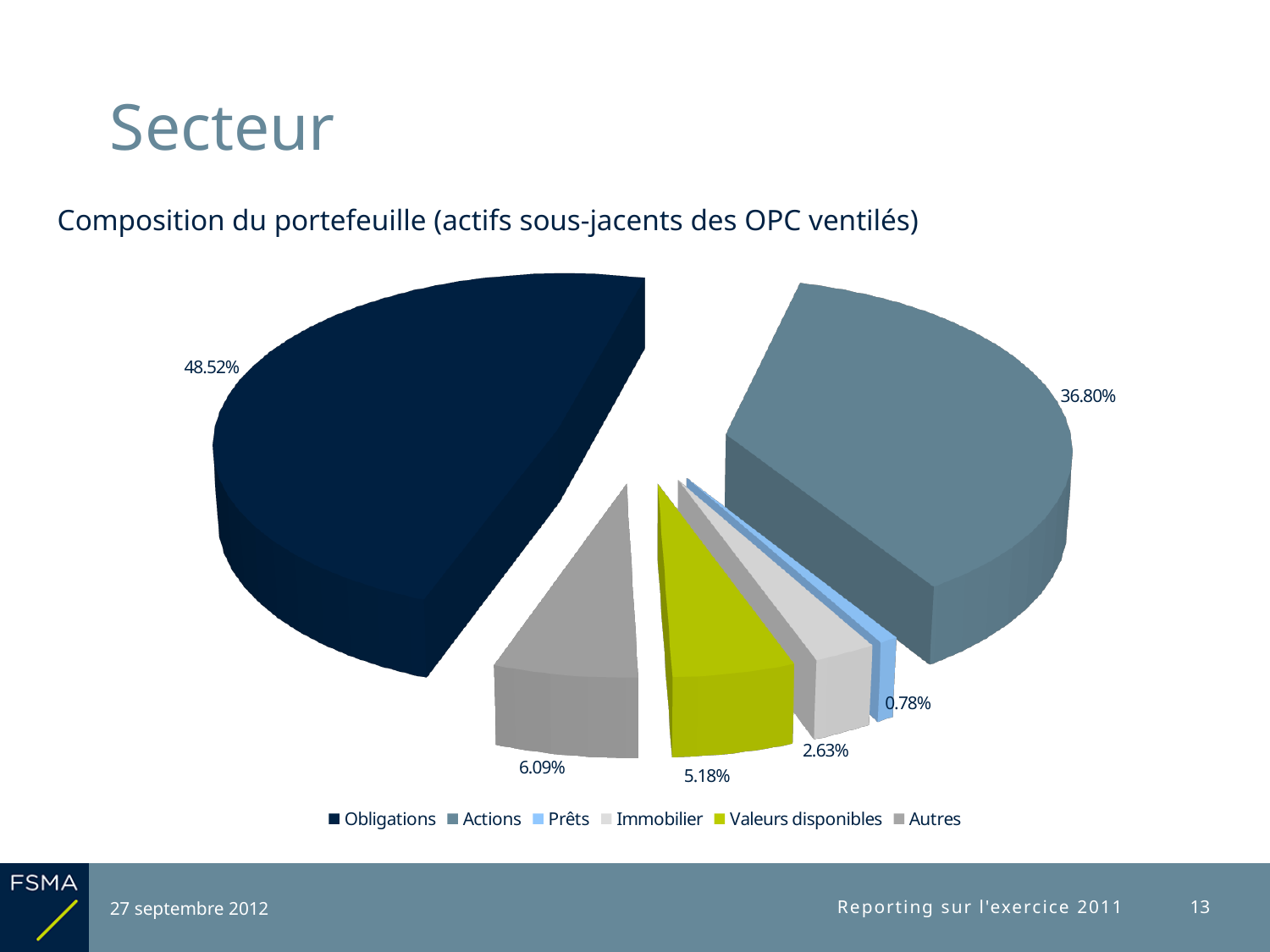
What share of the portfolio is Valeurs disponibles? 5.18% Which category has the largest share of the portfolio? Obligations Which is larger, the share of Autres or the share of Valeurs disponibles? Autres What share of the portfolio is Prêts? 0.78% What kind of chart is shown on the slide? Pie chart How many categories does the legend list? 6 What share of the portfolio is Obligations? 48.52% What share of the portfolio is Actions? 36.80% Which category has the smallest share of the portfolio? Prêts What share of the portfolio is Immobilier? 2.63% What is the difference between the shares of Obligations and Actions? 11.72% What share of the portfolio is Autres? 6.09%